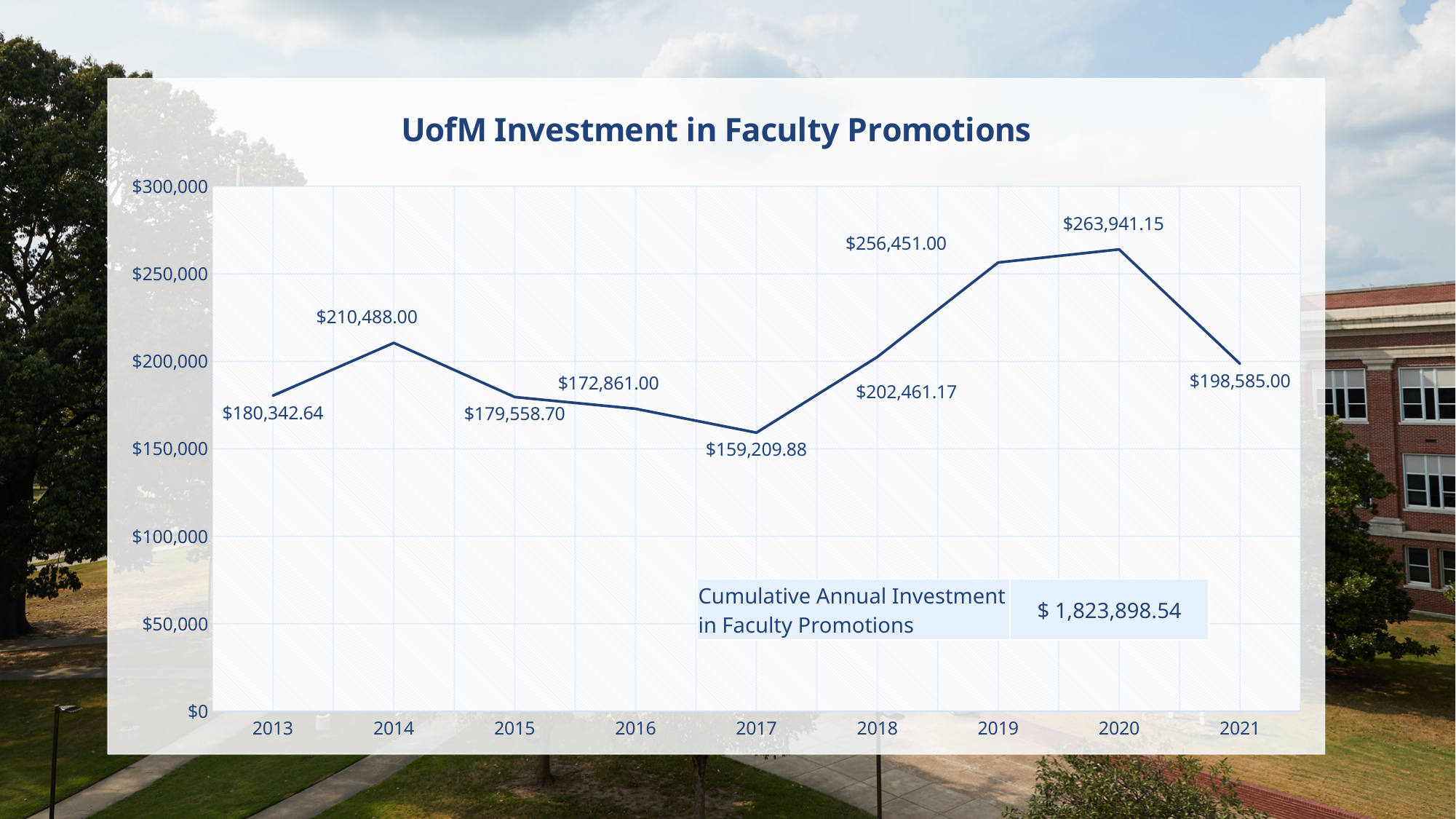
Is the value for 2016 greater or less than $200,000? less Which year had the lowest investment in faculty promotions? 2017 What kind of chart is shown on the slide? line chart What was the UofM investment in faculty promotions in 2013? $180,342.64 How many years are plotted on the chart? 9 Which year had the highest investment in faculty promotions? 2020 What value is shown for 2017? $159,209.88 How much greater was the investment in 2020 than in 2019? $7,490.15 What was the investment in faculty promotions in 2021? $198,585.00 Which year had a larger investment, 2014 or 2018? 2014 By how much did the investment fall from 2020 to 2021? $65,356.15 Do the values rise or fall from 2017 to 2020? rise